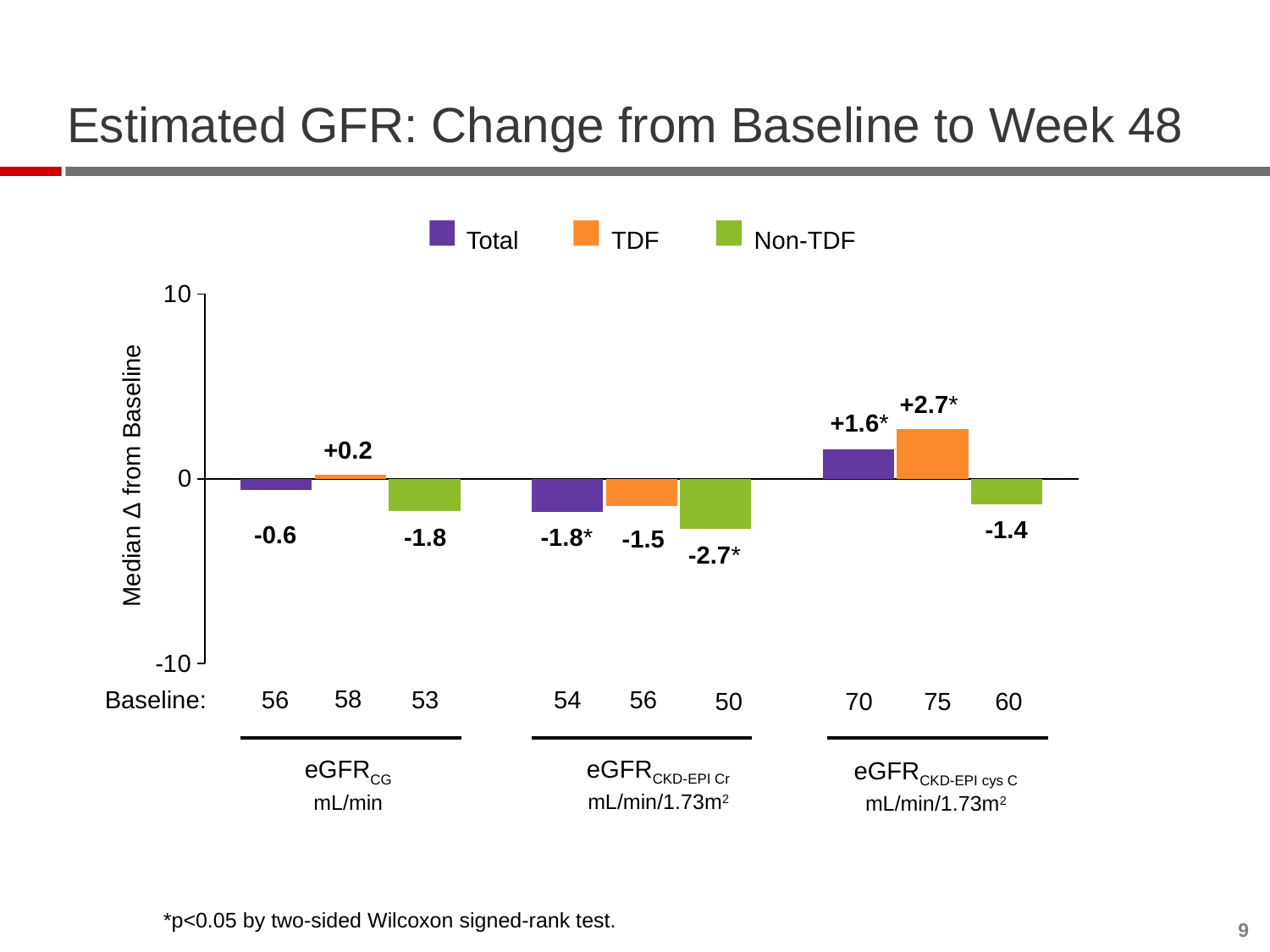
Which group has the highest median change from baseline under eGFR CKD-EPI cys C? TDF What is the median change from baseline for the Total group under eGFR CKD-EPI cys C? +1.6 What is the difference between the TDF and Total median changes under eGFR CKD-EPI cys C? 1.1 What is the median change from baseline for the TDF group under eGFR CG? +0.2 Which group has the lowest median change from baseline under eGFR CKD-EPI Cr? Non-TDF How many eGFR measures (category groups) are shown on the x axis? 3 How many series does the legend list? 3 What is the median change from baseline for the Non-TDF group under eGFR CKD-EPI cys C? -1.4 What is the median change from baseline for the Non-TDF group under eGFR CKD-EPI Cr? -2.7 What colour represents the Non-TDF group in the chart? Green What kind of chart is shown on the slide? Bar chart